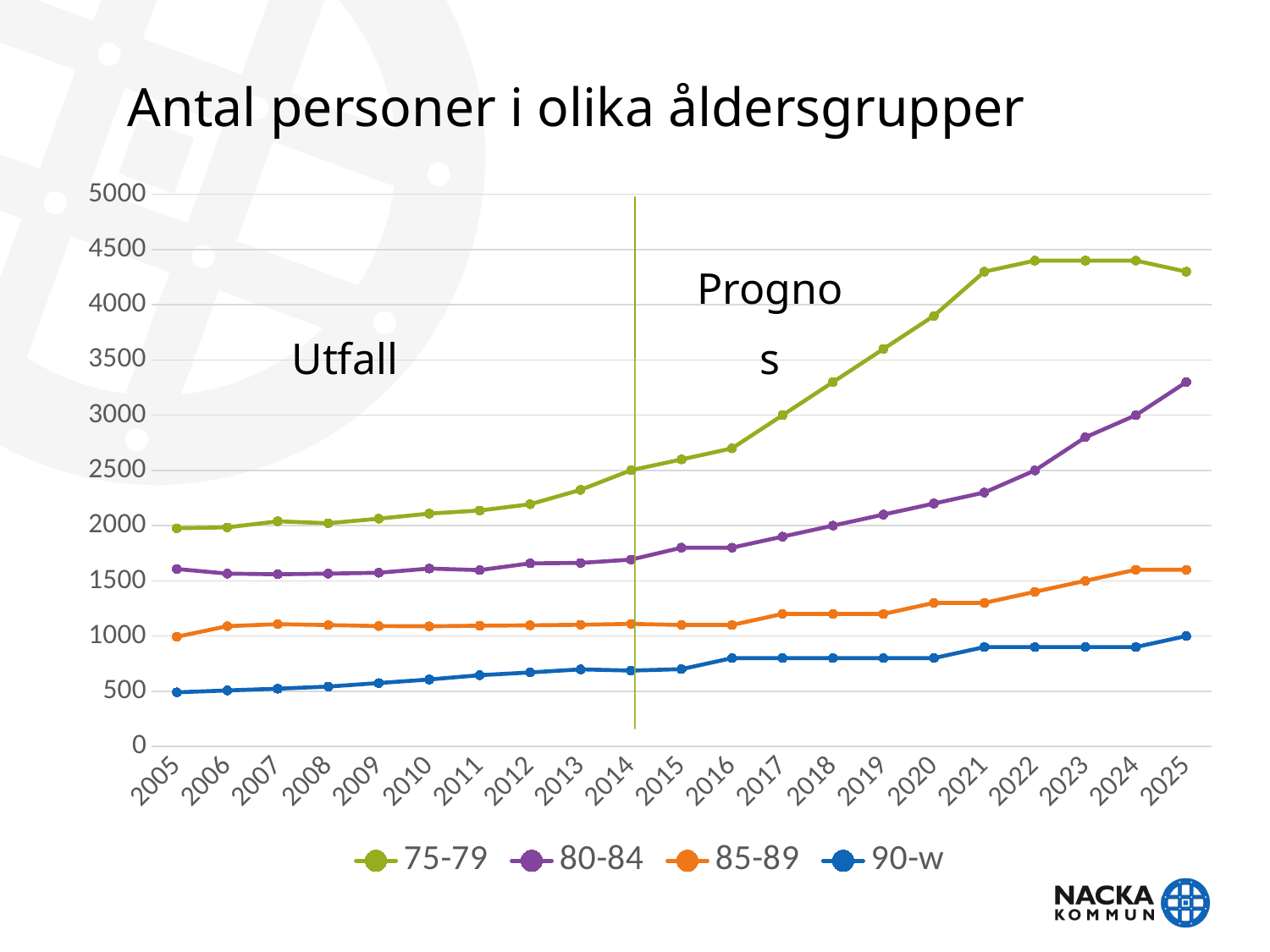
Is the value for 75-79 in 2022 greater or less than 4000? greater What is the title of the chart? Antal personer i olika åldersgrupper Is the value for 90-w in 2010 greater or less than 500? greater Which age group has the lowest value in 2025? 90-w Is the value for 85-89 in 2025 greater or less than 1500? greater What are the two labels written inside the plot area on either side of the vertical line? Utfall and Prognos How many series does the legend list? 4 Does the 75-79 line rise or fall from 2005 to 2022? rise How many years are plotted along the x axis? 21 Which age group has the highest value in 2025? 75-79 In 2025, which is larger: the value for 80-84 or the value for 85-89? 80-84 What kind of chart is shown on the slide? line chart